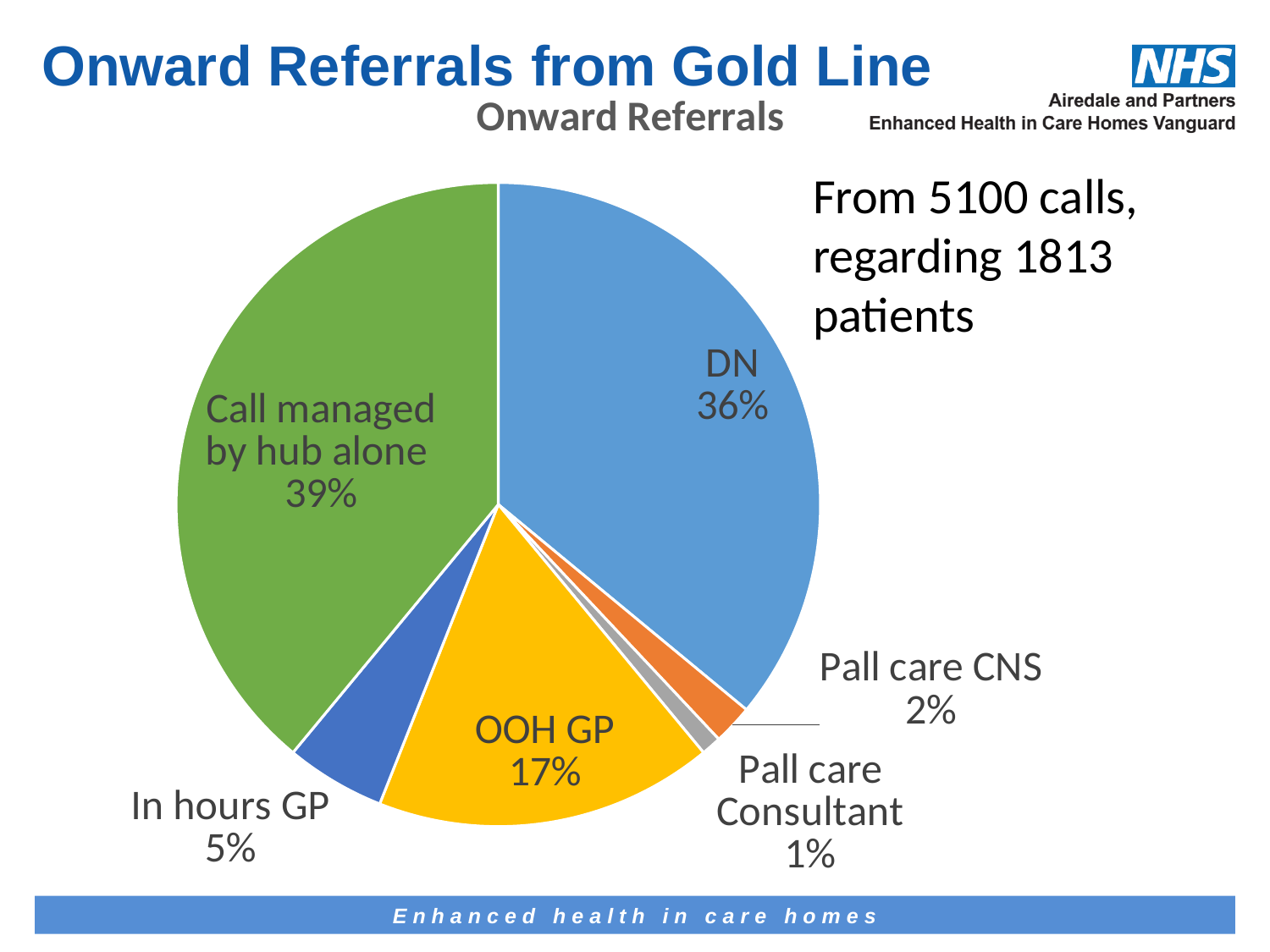
What is the difference in percentage points between OOH GP and In hours GP? 12 What is the chart's title? Onward Referrals What percentage of referrals went to OOH GP? 17% Which category has the smallest share of the pie? Pall care Consultant What percentage of referrals went to In hours GP? 5% Which category has the largest share of the pie? Call managed by hub alone What percentage of referrals went to Pall care CNS? 2% Which is larger, the share for DN or the share for OOH GP? DN What type of chart is shown on the slide? pie chart What percentage of onward referrals went to DN? 36% What share of calls were managed by hub alone? 39% How many categories are shown in the pie chart? 6